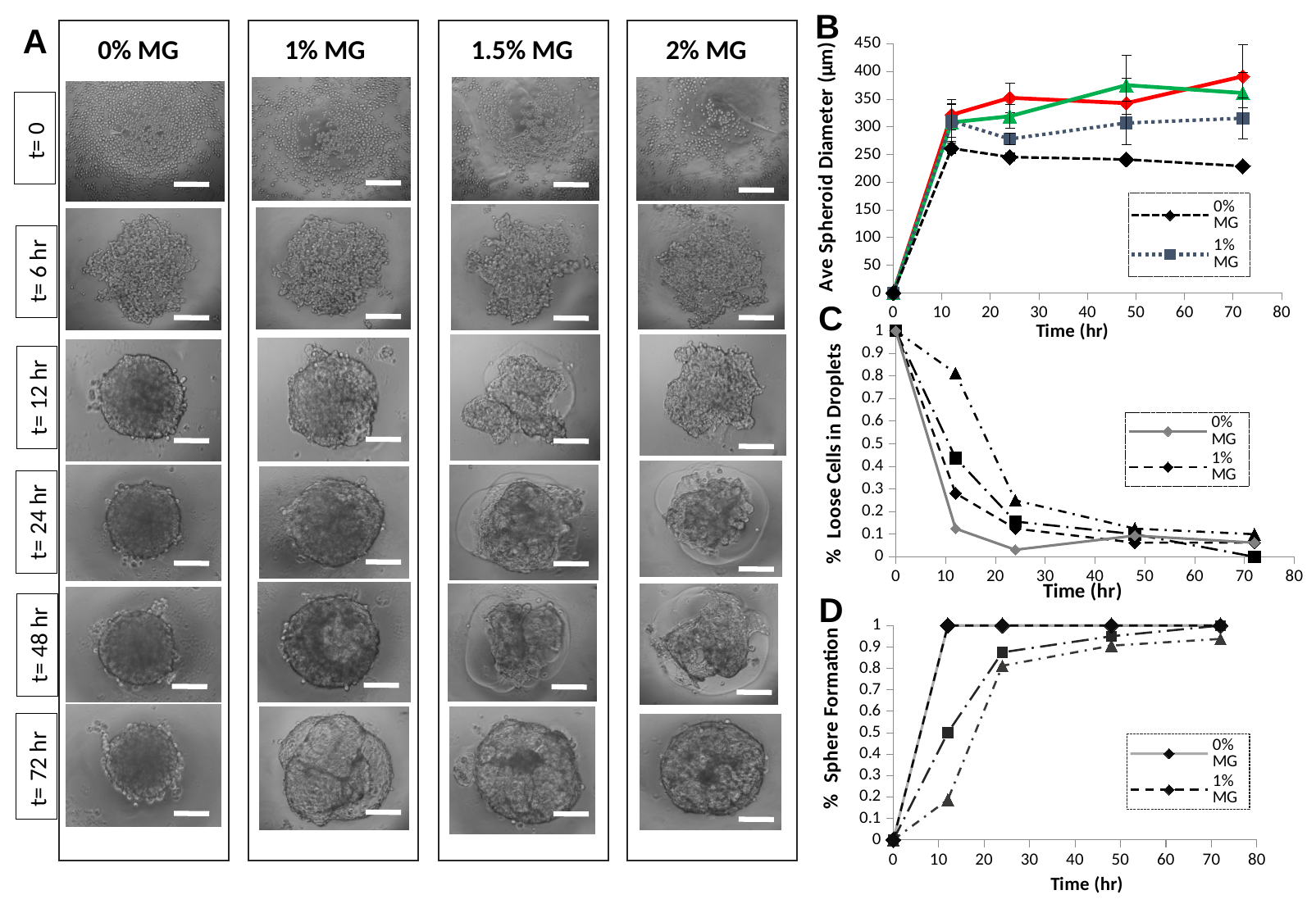
In chart C (% Loose Cells in Droplets), is the value for 1% MG at 12 hr greater or less than 0.5? less In chart B (Ave Spheroid Diameter), is the value for 0% MG at 72 hr greater or less than 250? less In chart D (% Sphere Formation), what is the value for 0% MG at 12 hr? 1 What kind of chart is chart B (Ave Spheroid Diameter)? line chart In chart D (% Sphere Formation), do the values for 1% MG rise or fall as time increases? rise In chart C (% Loose Cells in Droplets), do the values for 0% MG rise or fall as time increases? fall What is the label of the y axis in chart B? Ave Spheroid Diameter (µm) How many series does the legend of chart B list? 2 In chart C (% Loose Cells in Droplets), what is the value for 0% MG at time 0? 1 In chart B (Ave Spheroid Diameter), which series is higher at 72 hr, 0% MG or 1% MG? 1% MG In chart B (Ave Spheroid Diameter), is the value for 1% MG at 72 hr greater or less than 300? greater